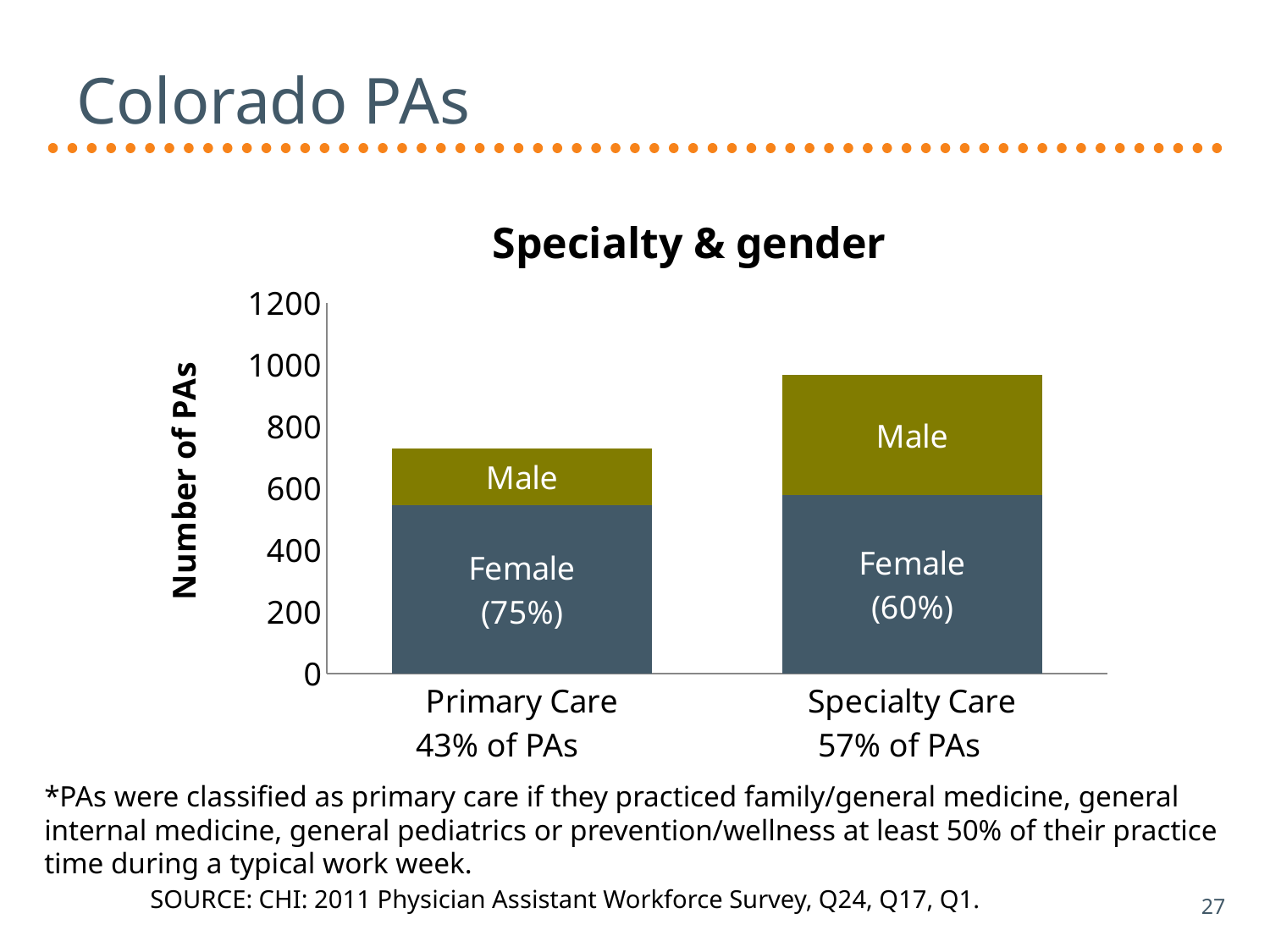
What is the label on the y axis of the chart? Number of PAs Is the total number of PAs in Specialty Care greater or less than 800? greater What is the title of the chart? Specialty & gender Is the total number of PAs in Specialty Care greater or less than 1000? less What percentage of Specialty Care PAs are female, according to the chart? 60% How many categories are shown on the x axis of the chart? 2 Which category has the taller bar, Primary Care or Specialty Care? Specialty Care What kind of chart is shown on the slide? Stacked bar chart Is the total number of PAs in Primary Care greater or less than 800? less What percentage of Primary Care PAs are female, according to the chart? 75% What share of PAs are in Specialty Care, according to the x-axis label? 57% of PAs What share of PAs are in Primary Care, according to the x-axis label? 43% of PAs